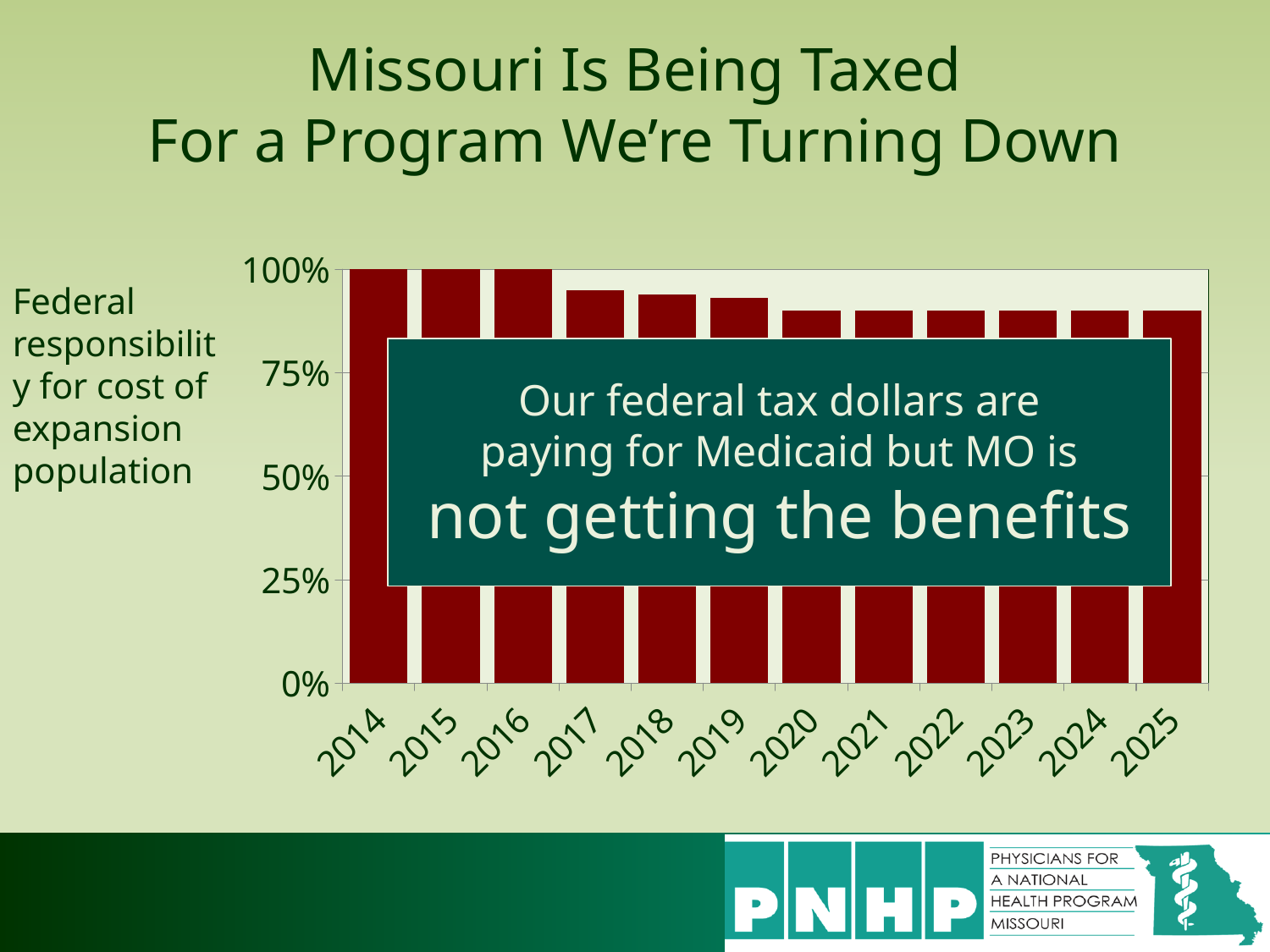
How many years are shown on the x axis of the chart? 12 Which is larger, the value for 2017 or the value for 2022? 2017 Which years in the chart have a value of 100%? 2014, 2015 and 2016 Is the value for 2020 greater or less than 75%? greater What does the label to the left of the chart say the bars represent? Federal responsibility for cost of expansion population Do the values in the chart rise or fall from 2014 to 2025? fall Is the value for 2017 greater or less than 75%? greater Is the value for 2025 greater or less than 100%? less What is the value for 2014 in the chart? 100% What is the value for 2016 in the chart? 100% Which is larger, the value for 2014 or the value for 2025? 2014 What kind of chart is shown on the slide? Bar chart